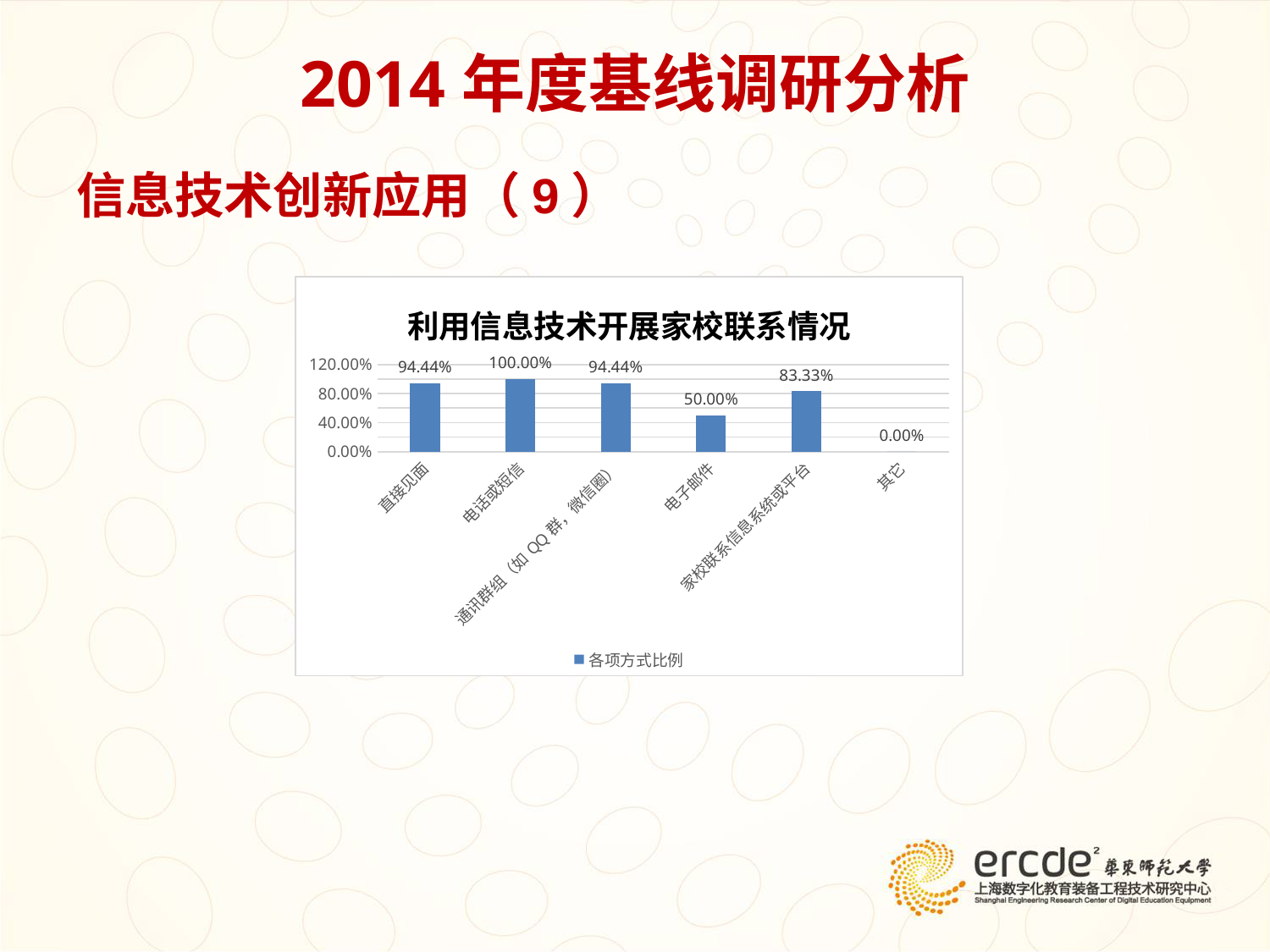
What is the value for 电子邮件? 50.00% What kind of chart is shown? bar chart How many categories are shown on the x axis? 6 Which is larger, the value for 家校联系信息系统或平台 or the value for 电子邮件? 家校联系信息系统或平台 Which category has the highest value? 电话或短信 What is the difference between the values for 电话或短信 and 电子邮件? 50.00% What is the title of the chart? 利用信息技术开展家校联系情况 Which category has the lowest value? 其它 How many series does the legend list? 1 What is the value for 其它? 0.00% What is the value for 家校联系信息系统或平台? 83.33% What is the value for 电话或短信? 100.00%